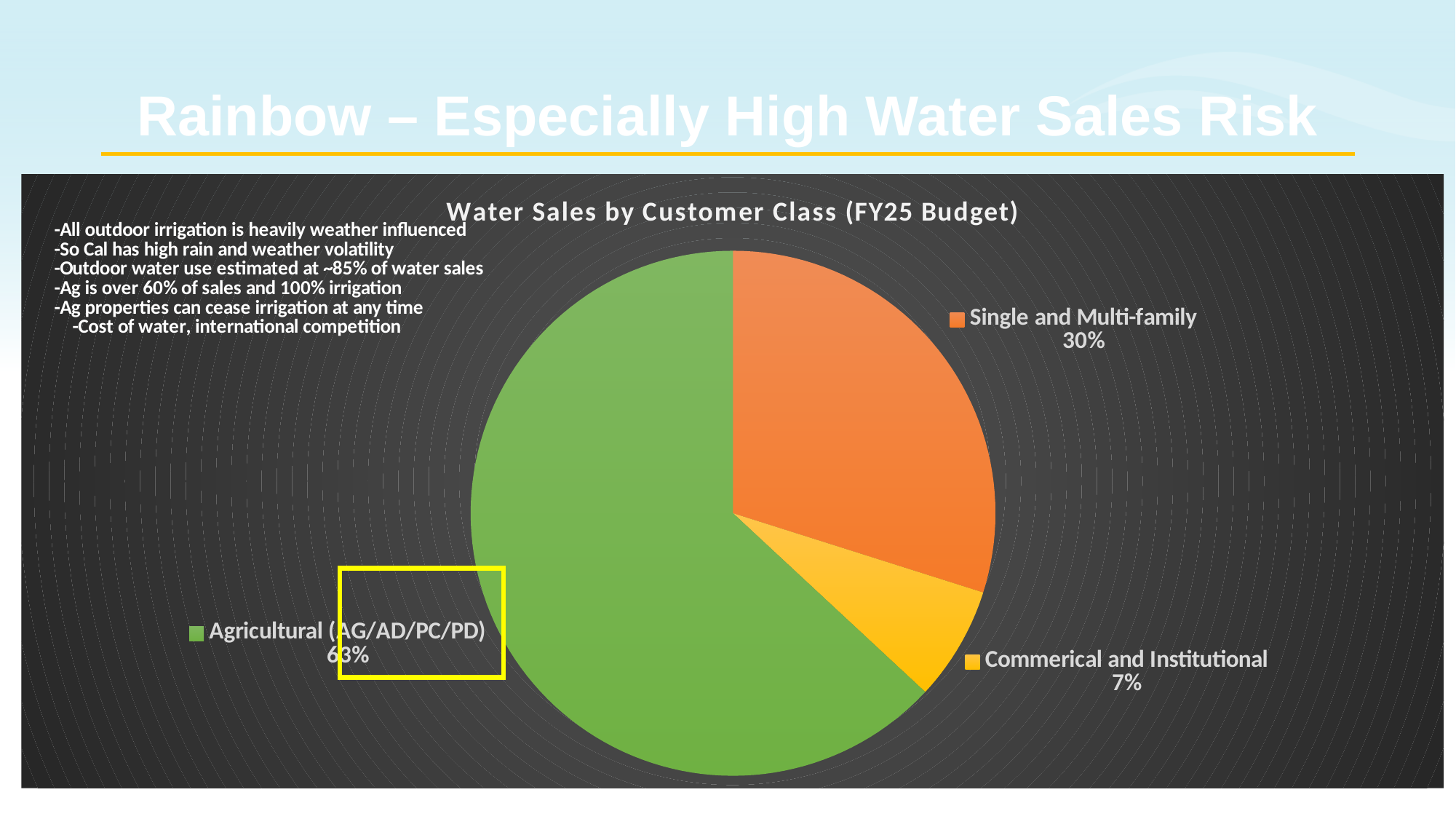
Which is larger, the share for Single and Multi-family or the share for Commerical and Institutional? Single and Multi-family How many slices does the pie chart have? 3 What colour is the Single and Multi-family slice? orange What share of water sales is Single and Multi-family? 30% What share of water sales is Agricultural (AG/AD/PC/PD)? 63% What is the title of the chart? Water Sales by Customer Class (FY25 Budget) What share of water sales is Commerical and Institutional? 7% Which customer class has the largest share of water sales? Agricultural (AG/AD/PC/PD) What is the difference in percentage points between the Single and Multi-family share and the Commerical and Institutional share? 23 What is the difference in percentage points between the Agricultural (AG/AD/PC/PD) share and the Single and Multi-family share? 33 Which customer class has the smallest share of water sales? Commerical and Institutional What kind of chart is shown on the slide? pie chart